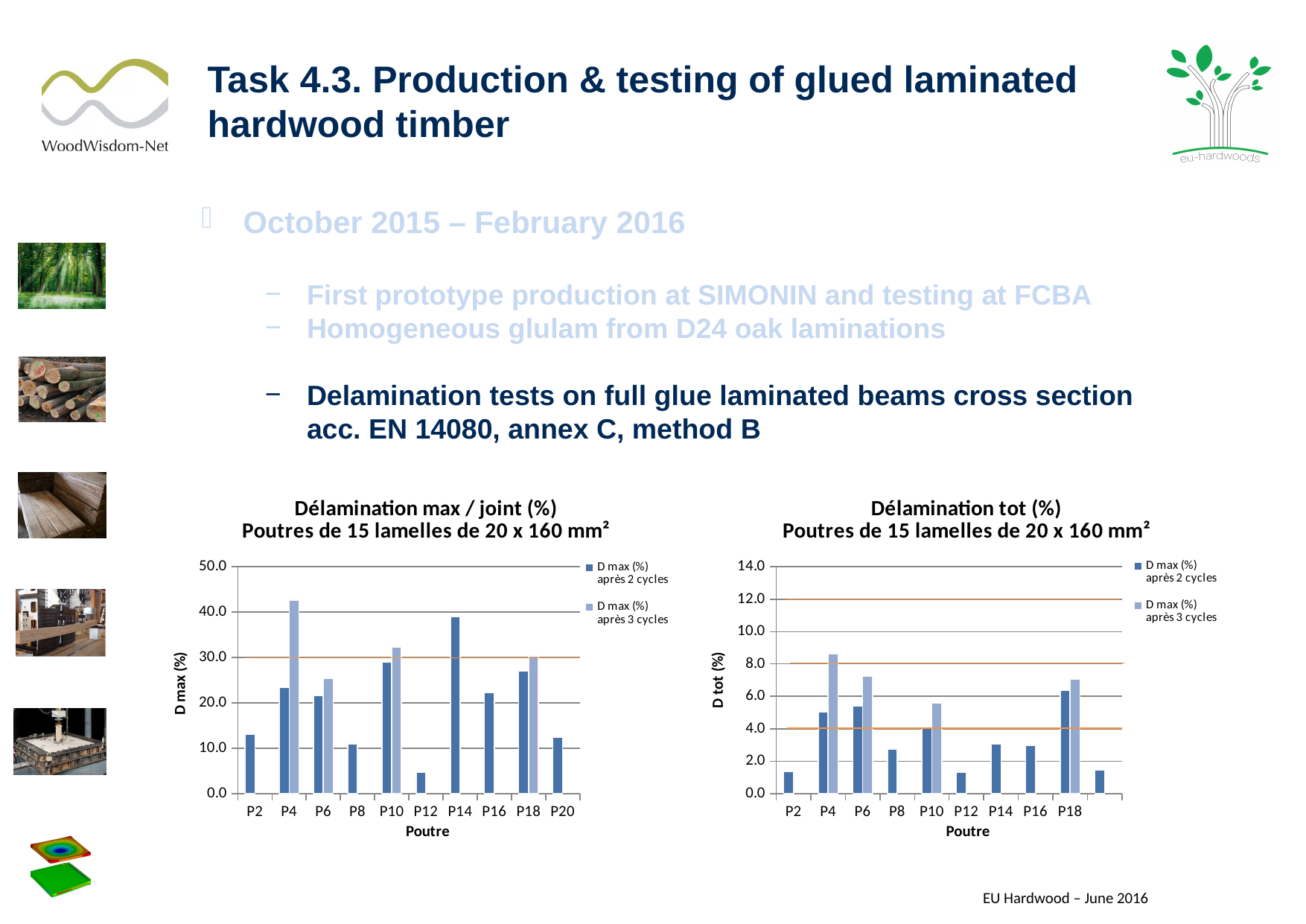
In the left chart, 'Délamination max / joint (%)', which beam has the highest bar overall? P4 In the right chart, 'Délamination tot (%)', is the value for P14 greater or less than 4.0? less In the left chart, 'Délamination max / joint (%)', which beam has the lowest bar? P12 What kind of chart is the left chart, 'Délamination max / joint (%)'? bar chart What is the x-axis title of the right chart, 'Délamination tot (%)'? Poutre In the left chart, 'Délamination max / joint (%)', how many beam categories are labelled on the x axis? 10 In the left chart, 'Délamination max / joint (%)', which is larger: the value for P14 or the value for P16? P14 In the left chart, 'Délamination max / joint (%)', is the value for P14 (après 2 cycles) greater or less than 30.0? greater How many series does the legend of the right chart, 'Délamination tot (%)', list? 2 In the right chart, 'Délamination tot (%)', is the value for P6 (après 3 cycles) greater or less than 8.0? less In the right chart, 'Délamination tot (%)', which beam has the highest bar overall? P4